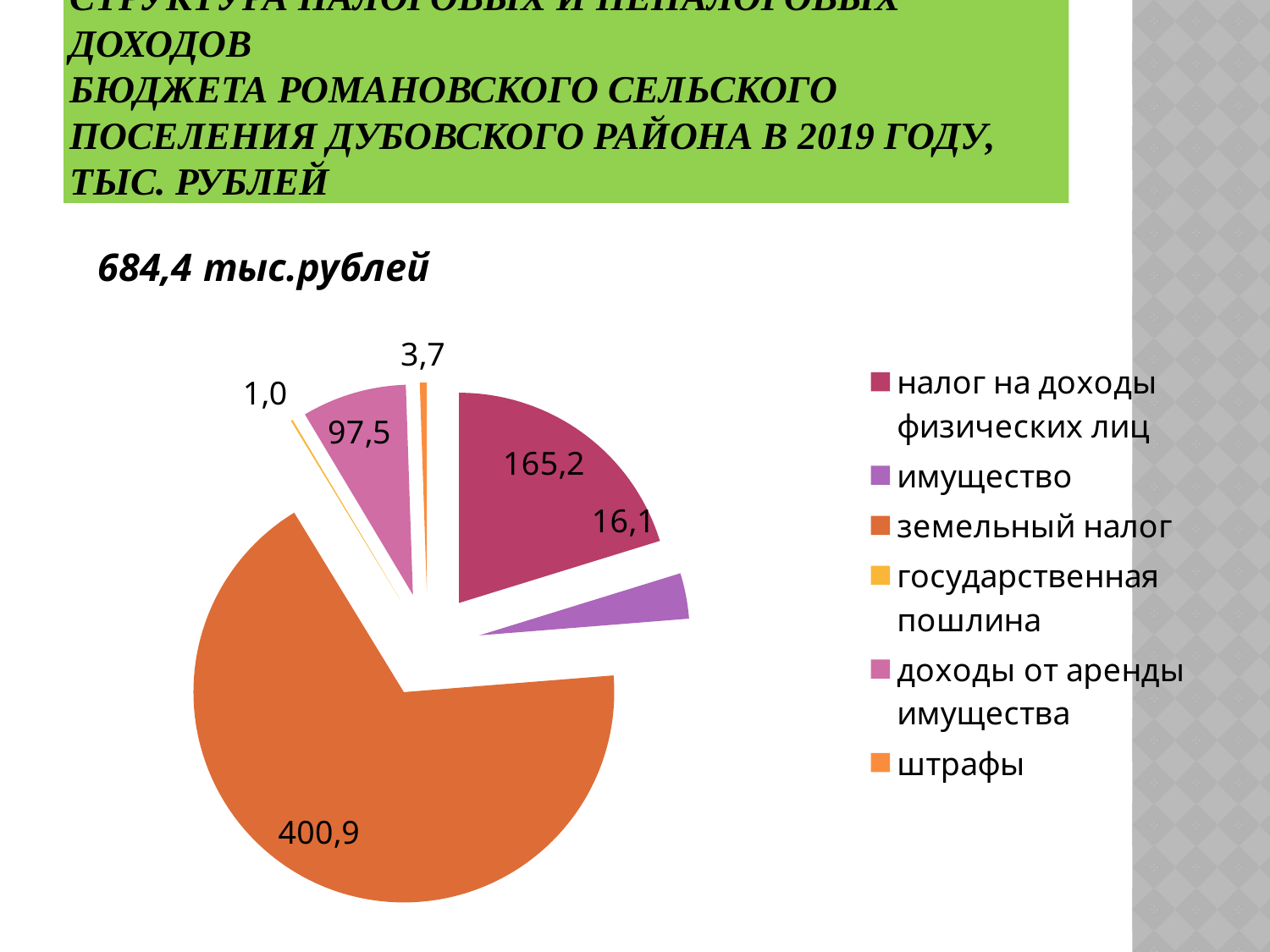
Which category has the smallest slice of the pie? государственная пошлина What type of chart is shown on the slide? pie chart What total amount is stated above the pie chart? 684,4 тыс.рублей What is the difference between земельный налог and налог на доходы физических лиц? 235,7 What colour is the slice for земельный налог? orange What is the value for налог на доходы физических лиц? 165,2 What is the value for земельный налог? 400,9 Which is larger, имущество or доходы от аренды имущества? доходы от аренды имущества How many categories does the pie chart show? 6 Which category has the largest slice of the pie? земельный налог What is the value for доходы от аренды имущества? 97,5 What is the value for штрафы? 3,7